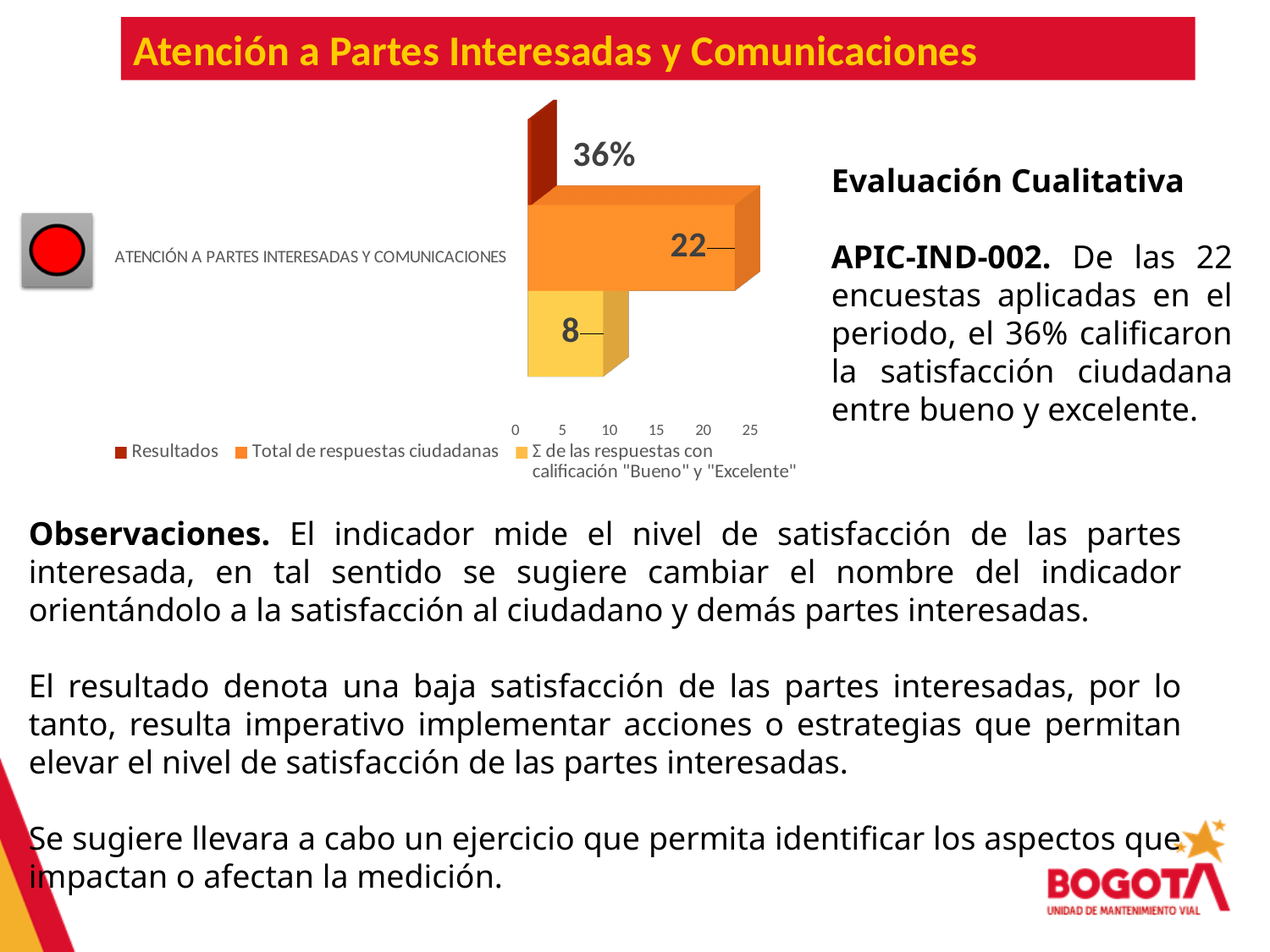
What is the highest tick value shown on the chart's horizontal axis? 25 What is the difference between the "Total de respuestas ciudadanas" value and the "Σ de las respuestas con calificación "Bueno" y "Excelente"" value? 14 What kind of chart is shown on the slide? Bar chart What is the value of the "Σ de las respuestas con calificación "Bueno" y "Excelente"" series in the chart? 8 Which series has the longest bar in the chart? Total de respuestas ciudadanas How many series does the chart legend list? 3 What category label is shown on the chart's vertical axis? ATENCIÓN A PARTES INTERESADAS Y COMUNICACIONES What is the value of the "Total de respuestas ciudadanas" series in the chart? 22 Which is larger, the "Total de respuestas ciudadanas" bar or the "Σ de las respuestas con calificación "Bueno" y "Excelente"" bar? Total de respuestas ciudadanas What value is labelled on the "Resultados" series in the chart? 36% Is the value for "Total de respuestas ciudadanas" greater or less than 20? greater Is the value for "Σ de las respuestas con calificación "Bueno" y "Excelente"" greater or less than 10? less